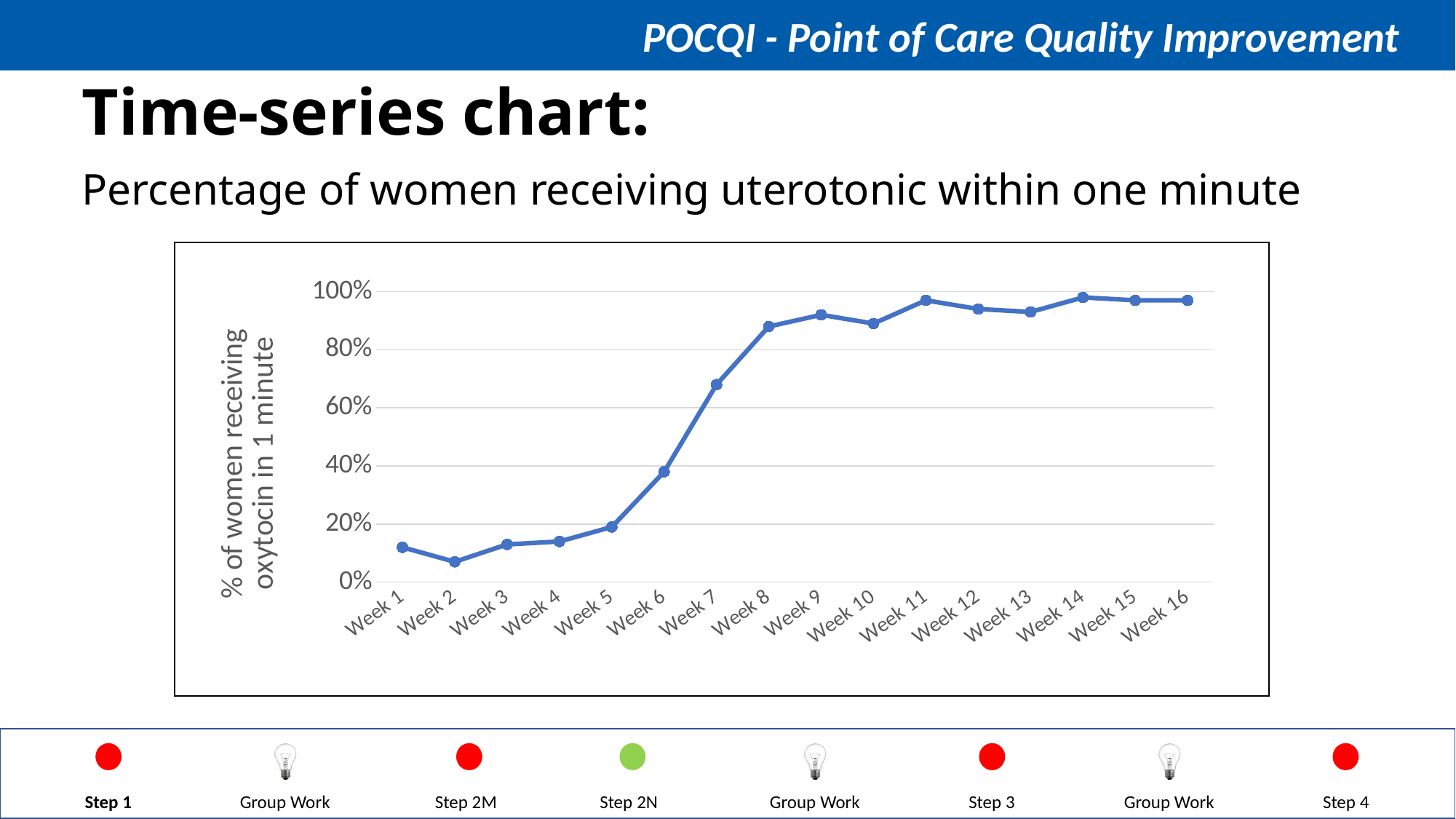
Which is larger, the value for Week 2 or the value for Week 4? Week 4 Is the value for Week 3 greater or less than 20%? less Is the value for Week 6 greater or less than 20%? greater Overall, do the values rise or fall from Week 1 to Week 16? rise How many weeks are plotted on the x axis of the chart? 16 Is the value for Week 8 greater or less than 80%? greater What kind of chart is shown on the slide? line chart What is the label on the vertical axis of the chart? % of women receiving oxytocin in 1 minute Which week has the lowest percentage of women receiving oxytocin in 1 minute? Week 2 Which is larger, the value for Week 6 or the value for Week 7? Week 7